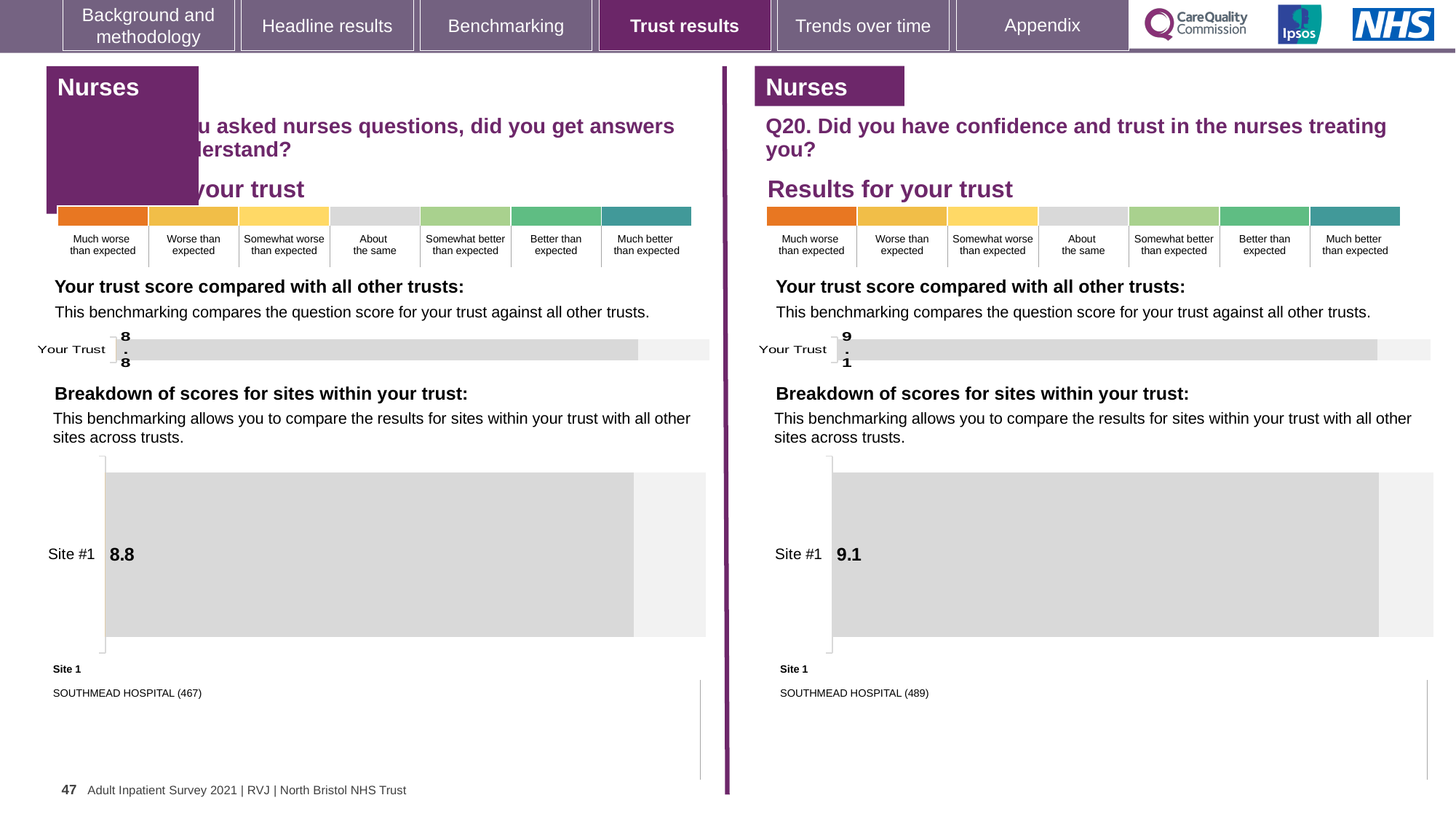
On the right half of the slide (Q20, confidence and trust in nurses), what is the score shown for Your Trust in the 'Your trust score compared with all other trusts' chart? 9.1 How many sites are plotted in the left 'Breakdown of scores for sites within your trust' chart? 1 In the left 'Breakdown of scores for sites within your trust' chart, what is the value labelled for Site #1? 8.8 What kind of chart is used to show the Site #1 score in the right (Q20) breakdown section? Bar chart What is the difference between the Site #1 score in the right (Q20) breakdown chart and the Site #1 score in the left breakdown chart? 0.3 On the left half of the slide, what is the score shown for Your Trust in the 'Your trust score compared with all other trusts' chart? 8.8 Which is larger: the Your Trust score on the left chart or the Your Trust score on the right (Q20) chart? The right (Q20) chart, 9.1 In the right 'Breakdown of scores for sites within your trust' chart (Q20), what is the value labelled for Site #1? 9.1 Which hospital is listed as Site 1 below the left breakdown chart? SOUTHMEAD HOSPITAL (467) How many sites are plotted in the right (Q20) 'Breakdown of scores for sites within your trust' chart? 1 Which hospital is listed as Site 1 below the right (Q20) breakdown chart? SOUTHMEAD HOSPITAL (489)